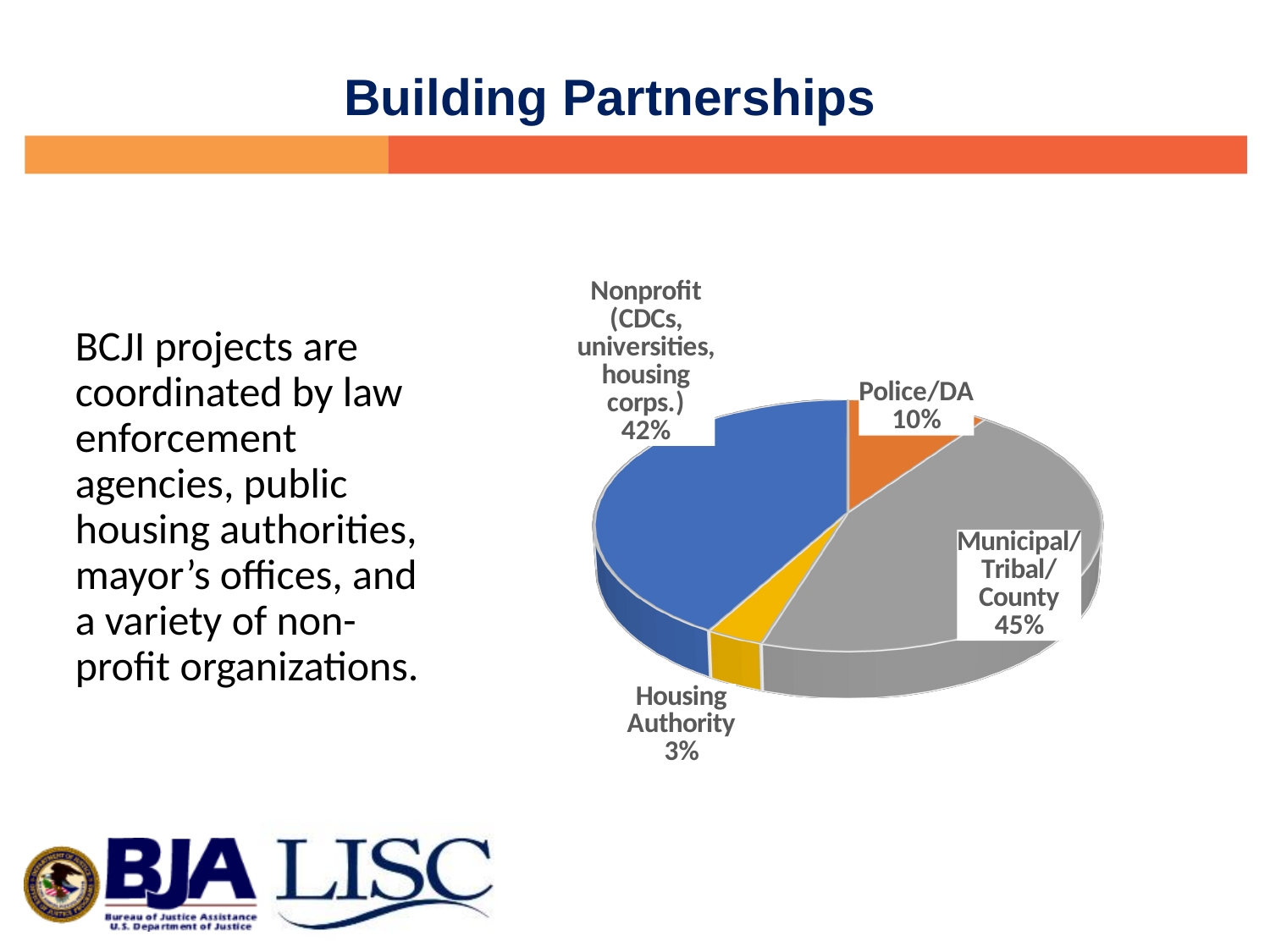
What share of the pie does Nonprofit (CDCs, universities, housing corps.) represent? 42% What is the difference in percentage points between Municipal/Tribal/County and Police/DA? 35 What kind of chart is shown on the slide? Pie chart Which category has the largest share of the pie? Municipal/Tribal/County Which is larger, the share for Nonprofit (CDCs, universities, housing corps.) or the share for Police/DA? Nonprofit (CDCs, universities, housing corps.) Which category has the smallest share of the pie? Housing Authority What is the difference in percentage points between Police/DA and Housing Authority? 7 How many categories are shown in the pie chart? 4 What share of the pie does Police/DA represent? 10% What share of the pie does Housing Authority represent? 3% What colour is the Police/DA slice of the pie? Orange What share of the pie does Municipal/Tribal/County represent? 45%